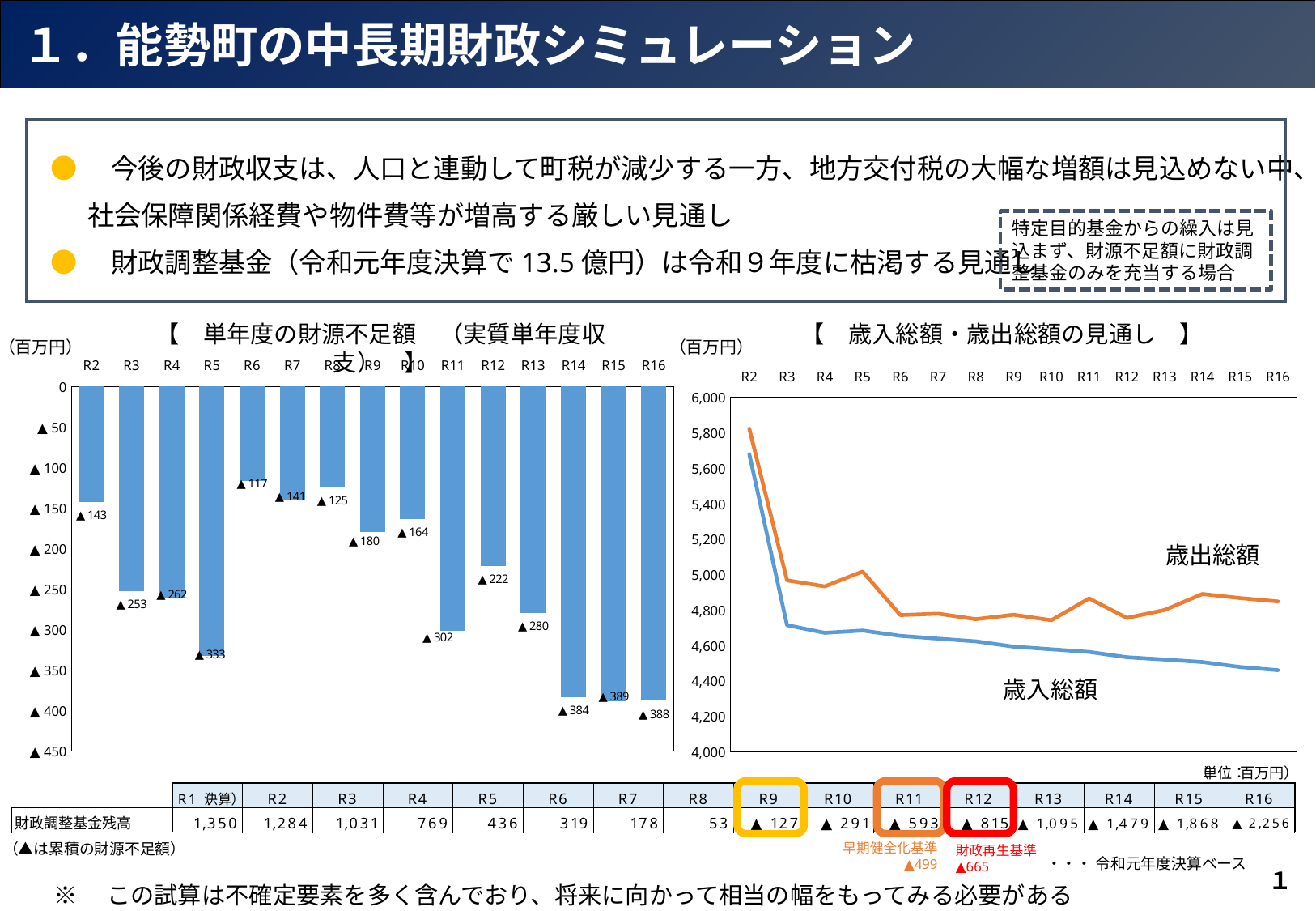
In the left chart (単年度の財源不足額), what is the difference between the values for R5 and R2? 190 In the left chart (単年度の財源不足額), which has the larger shortfall, R10 or R11? R11 In the left chart (単年度の財源不足額), what is the value for R5? ▲333 In the right chart (歳入総額・歳出総額の見通し), is the value of 歳入総額 at R16 greater or less than 4,600? less In the right chart (歳入総額・歳出総額の見通し), does 歳入総額 rise or fall from R2 to R16? Fall In the left chart (単年度の財源不足額), what is the value for R13? ▲280 In the left chart (単年度の財源不足額), which year has the smallest shortfall (shortest bar)? R6 What kind of chart is the right chart (歳入総額・歳出総額の見通し)? Line chart How many series are plotted in the right chart (歳入総額・歳出総額の見通し)? 2 In the right chart (歳入総額・歳出総額の見通し), which series is higher at R16, 歳出総額 or 歳入総額? 歳出総額 How many years (bars) are shown in the left chart (単年度の財源不足額)? 15 What kind of chart is the left chart (単年度の財源不足額)? Bar chart